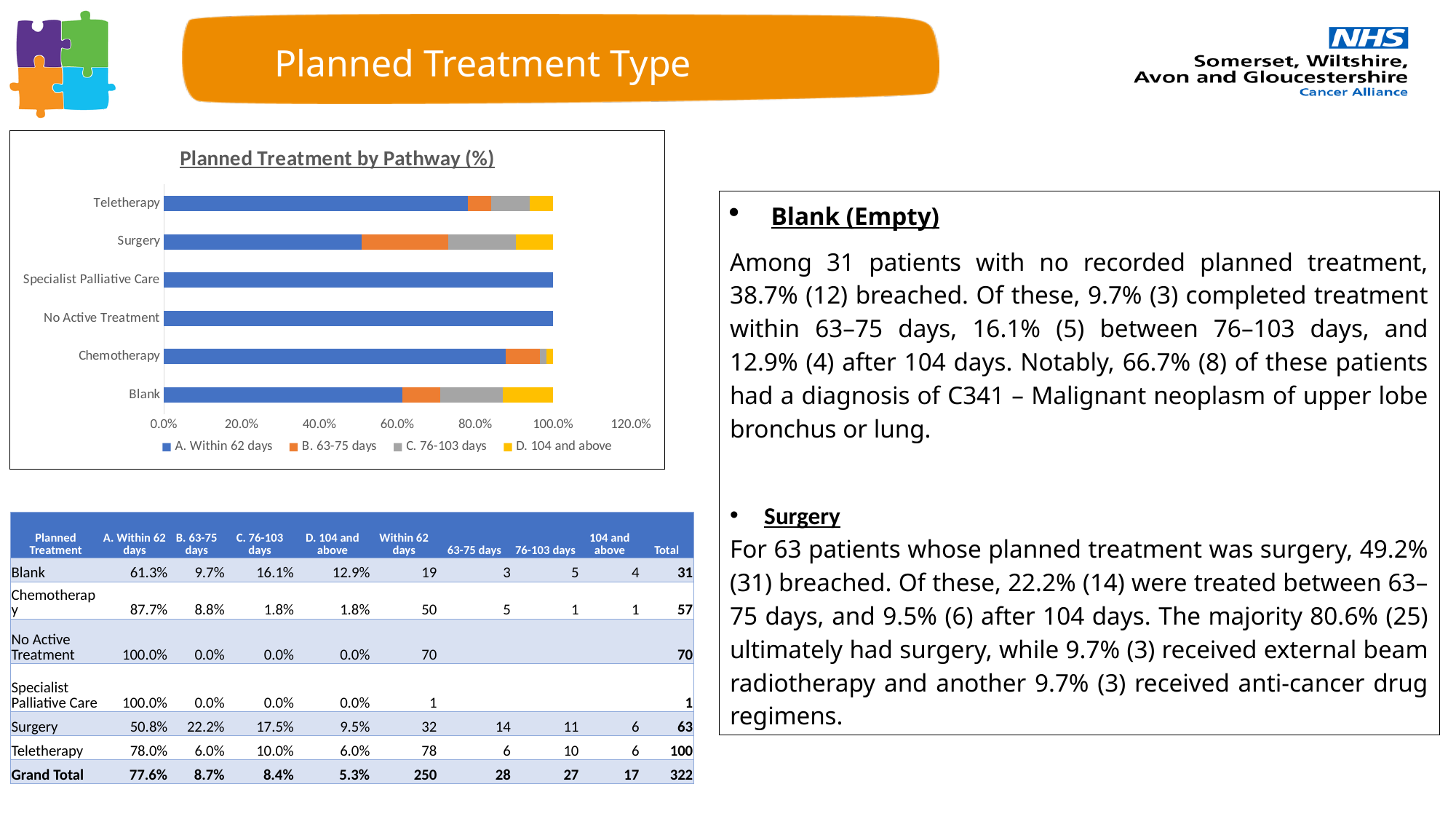
In the "Planned Treatment by Pathway (%)" chart, is the "A. Within 62 days" value for Surgery greater or less than 60.0%? less How many series does the legend of the "Planned Treatment by Pathway (%)" chart list? 4 What kind of chart is "Planned Treatment by Pathway (%)"? Stacked bar chart According to the table on the slide, what is the "A. Within 62 days" percentage plotted for Surgery in the "Planned Treatment by Pathway (%)" chart? 50.8% In the "Planned Treatment by Pathway (%)" chart, which has the larger "A. Within 62 days" segment, Surgery or Teletherapy? Teletherapy In the "Planned Treatment by Pathway (%)" chart, which has the larger "A. Within 62 days" segment, Blank or Chemotherapy? Chemotherapy According to the table on the slide, what is the "D. 104 and above" percentage plotted for Blank in the "Planned Treatment by Pathway (%)" chart? 12.9% How many planned treatment categories are shown on the y axis of the "Planned Treatment by Pathway (%)" chart? 6 What colour represents "D. 104 and above" in the "Planned Treatment by Pathway (%)" chart? Yellow In the "Planned Treatment by Pathway (%)" chart, is the "A. Within 62 days" value for Chemotherapy greater or less than 80.0%? greater Using the percentages in the table, what is the difference between the "A. Within 62 days" values for Teletherapy and Surgery in the "Planned Treatment by Pathway (%)" chart? 27.2 percentage points In the "Planned Treatment by Pathway (%)" chart, which category has the smallest "A. Within 62 days" segment? Surgery